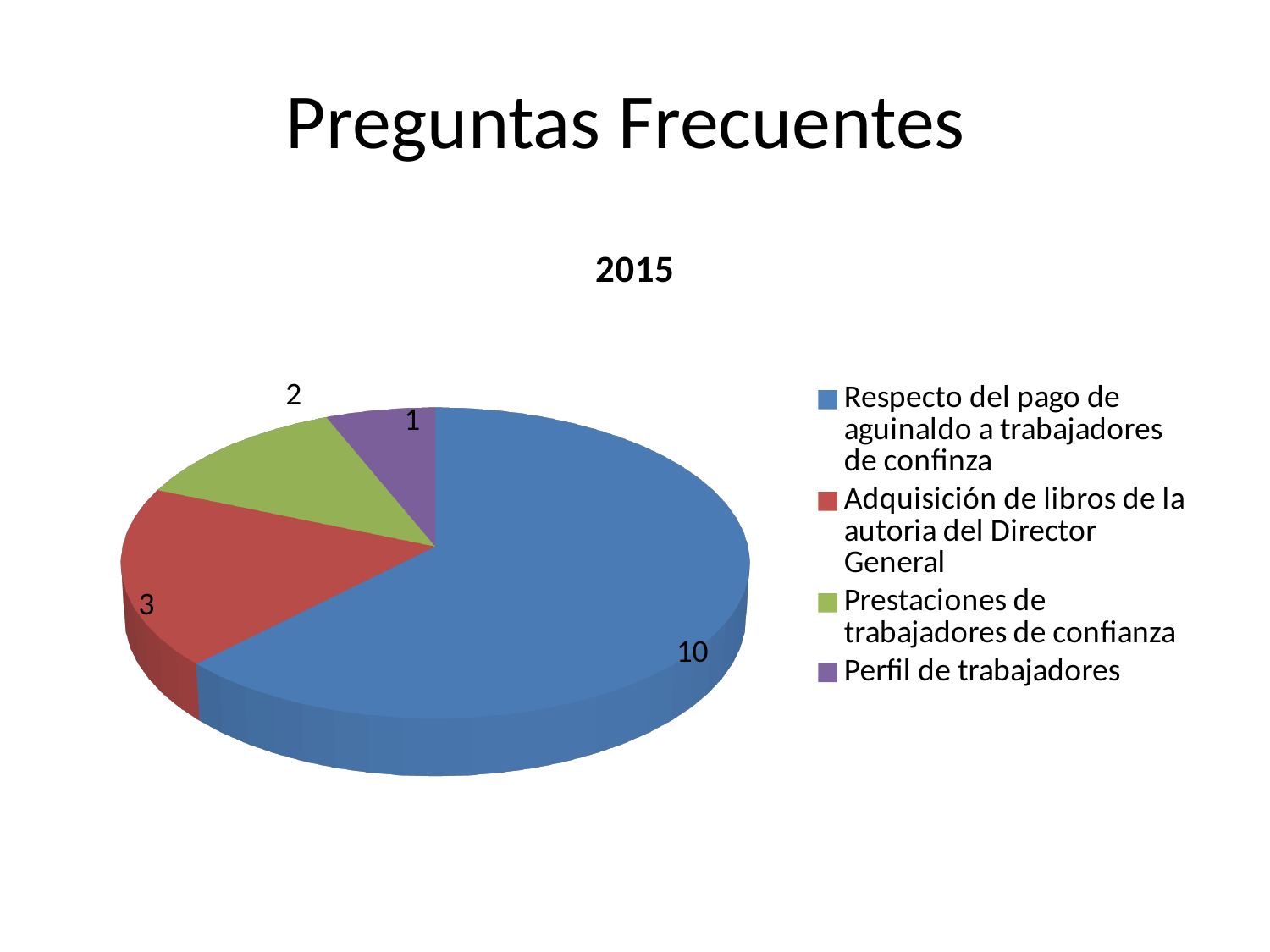
How many categories does the pie chart have? 4 Which category has the largest slice? Respecto del pago de aguinaldo a trabajadores de confinza Which category has the smallest slice? Perfil de trabajadores Which is larger: 'Prestaciones de trabajadores de confianza' or 'Perfil de trabajadores'? Prestaciones de trabajadores de confianza What kind of chart is shown on the slide? pie chart What is the value for 'Adquisición de libros de la autoria del Director General'? 3 What share of the pie does 'Respecto del pago de aguinaldo a trabajadores de confinza' represent? 62.5% What is the value for 'Perfil de trabajadores'? 1 What is the title of the chart? 2015 What is the value for 'Prestaciones de trabajadores de confianza'? 2 What is the difference between the values for 'Respecto del pago de aguinaldo a trabajadores de confinza' and 'Adquisición de libros de la autoria del Director General'? 7 What is the value for 'Respecto del pago de aguinaldo a trabajadores de confinza'? 10